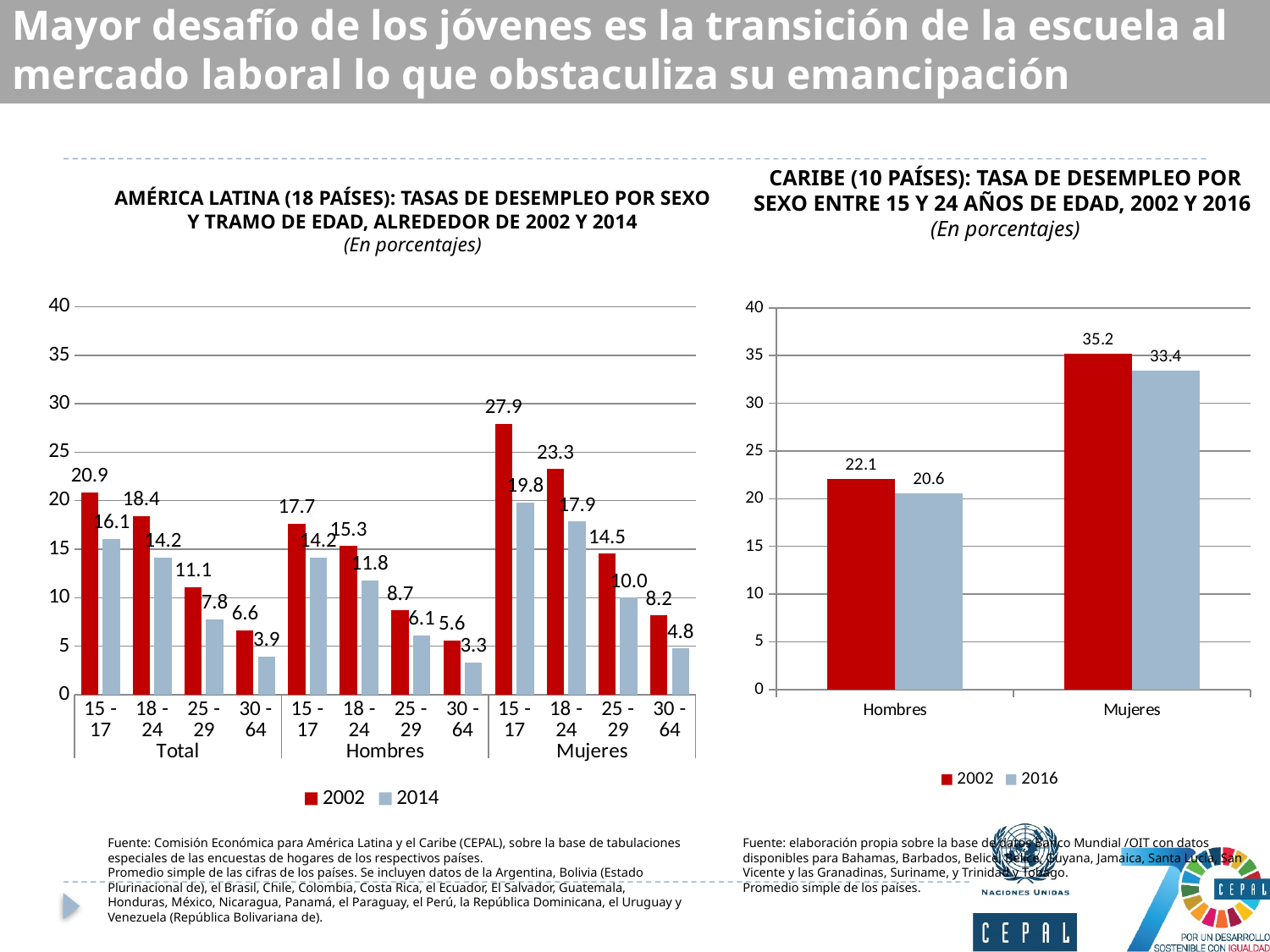
In the Caribe chart on the right, how many series does the legend list? 2 What type of chart is the Caribe chart on the right? Bar chart In the América Latina chart on the left, how many age-group categories are shown on the x axis in total? 12 In the América Latina chart on the left, which category has the highest 2002 value? Mujeres 15-17 In the América Latina chart on the left, what is the difference between the 2002 and 2014 values for Total aged 18-24? 4.2 In the América Latina chart on the left, which is larger: the 2002 value for Hombres 15-17 or the 2002 value for Mujeres 18-24? Mujeres 18-24 In the América Latina chart on the left, what is the 2014 value for Hombres aged 30-64? 3.3 In the América Latina chart on the left, which category has the lowest 2014 value? Hombres 30-64 In the Caribe chart on the right, what is the unemployment rate for Mujeres in 2002? 35.2 In the América Latina chart on the left, what is the 2002 unemployment rate for Mujeres aged 15-17? 27.9 In the Caribe chart on the right, what is the difference between the 2002 and 2016 values for Mujeres? 1.8 In the Caribe chart on the right, what is the value for Hombres in 2016? 20.6